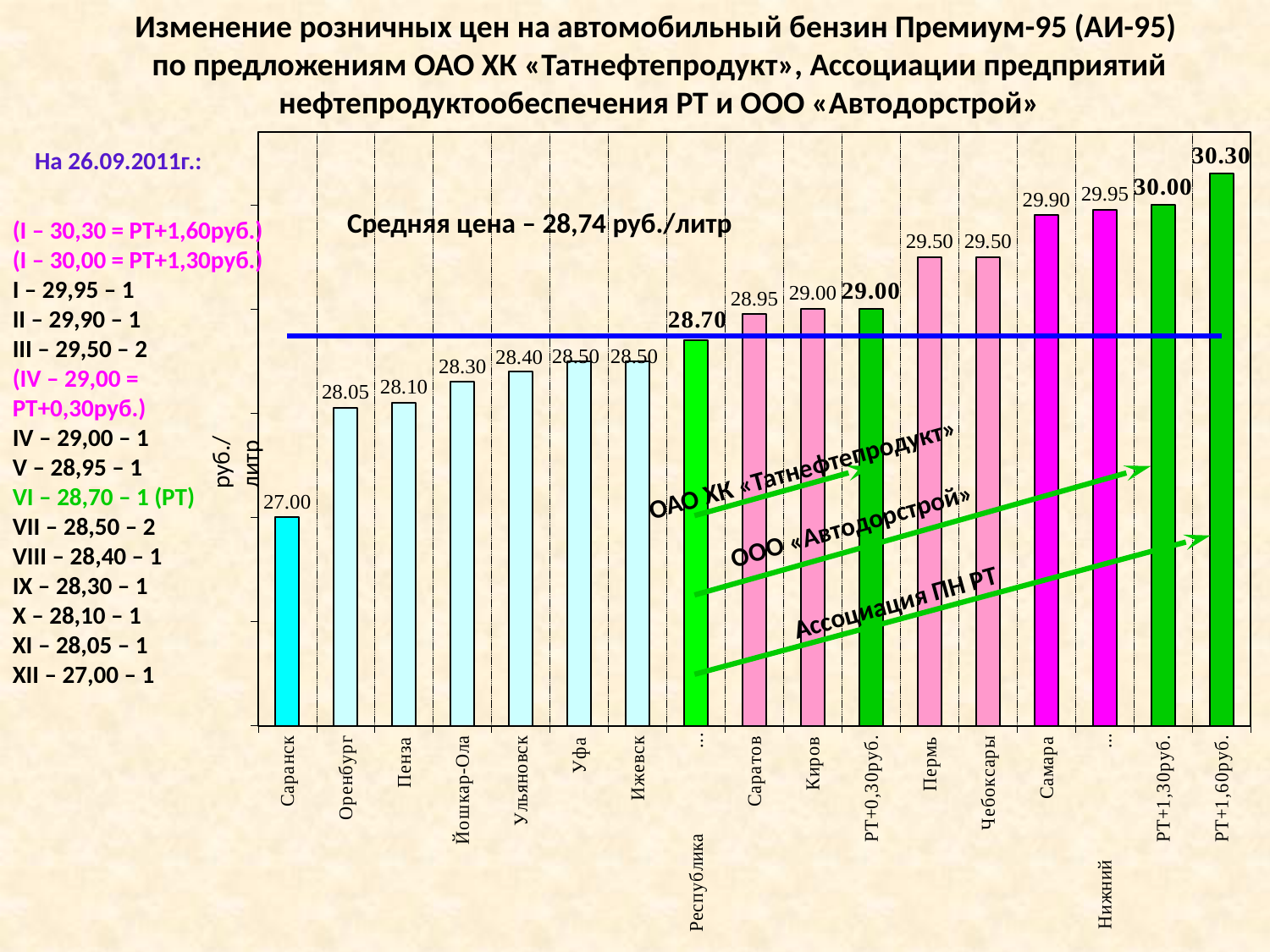
What kind of chart is shown on the slide? Bar chart What is the difference between the values for РТ+1,60руб. and Саранск? 3.30 What is the retail price shown for Саранск? 27.00 What is the value shown for Пермь? 29.50 Which category has the highest value on the chart? РТ+1,60руб. Which has a higher value, Киров or Ульяновск? Киров What is the difference between the values for Саратов and Оренбург? 0.90 How many bars are plotted on the chart? 17 What is the value shown for the bar labelled Республика...? 28.70 What is the value shown for Самара? 29.90 Which category has the lowest value on the chart? Саранск What average price is stated on the chart (Средняя цена)? 28,74 руб./литр